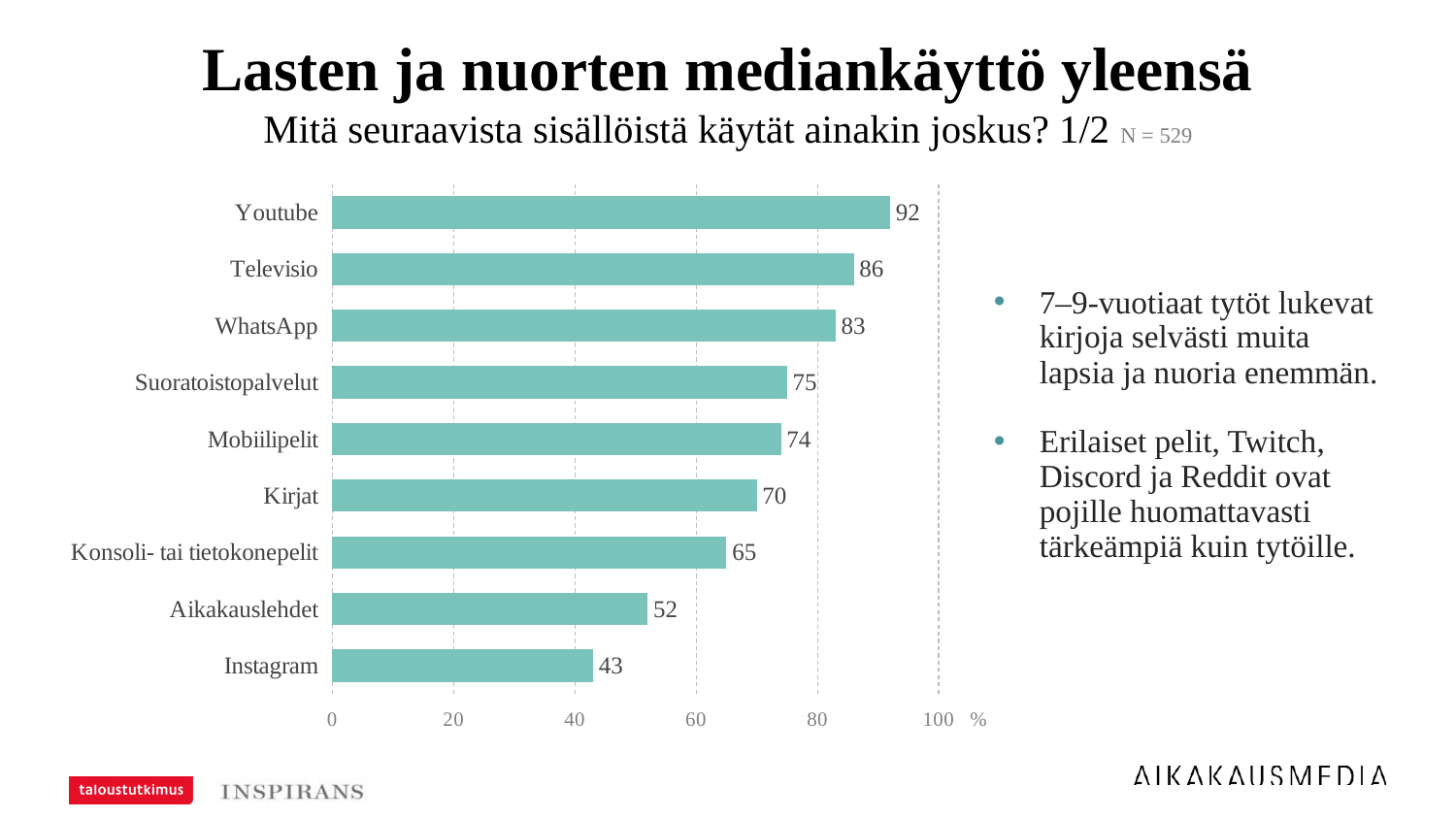
What is the value for Kirjat? 70 Which category has the highest value? Youtube How many categories are shown in the chart? 9 What is the value for Youtube? 92 Which category has the lowest value? Instagram What kind of chart is shown on the slide? bar chart Which is larger, the value for Mobiilipelit or the value for Konsoli- tai tietokonepelit? Mobiilipelit What is the difference between the values for Youtube and Instagram? 49 What is the value for Aikakauslehdet? 52 What is the difference between the values for Televisio and WhatsApp? 3 Is the value for Suoratoistopalvelut greater or less than 60? greater What is the sample size (N) shown on the slide? 529